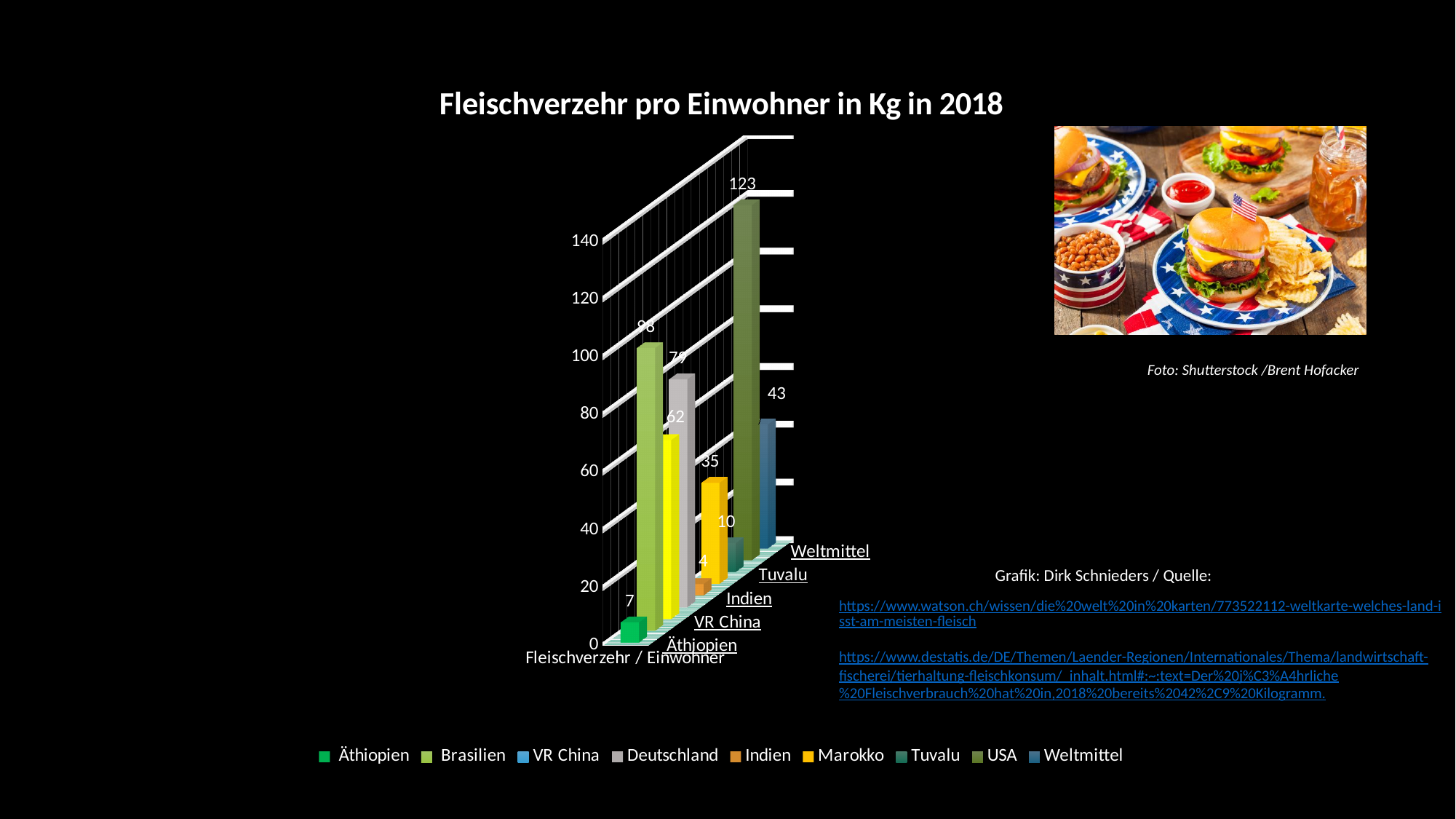
What is the value for USA? 123 What is the title of the chart? Fleischverzehr pro Einwohner in Kg in 2018 What is the value for Äthiopien? 7 How many series does the legend list? 9 What is the value for Deutschland? 79 What is the difference between the value for USA and the value for Weltmittel? 80 What is the value for Weltmittel? 43 Which series has the lowest value? Indien Which country has the highest meat consumption per inhabitant? USA What is the value for Brasilien? 98 Which is larger, the value for Brasilien or the value for Deutschland? Brasilien What kind of chart is shown on the slide? bar chart